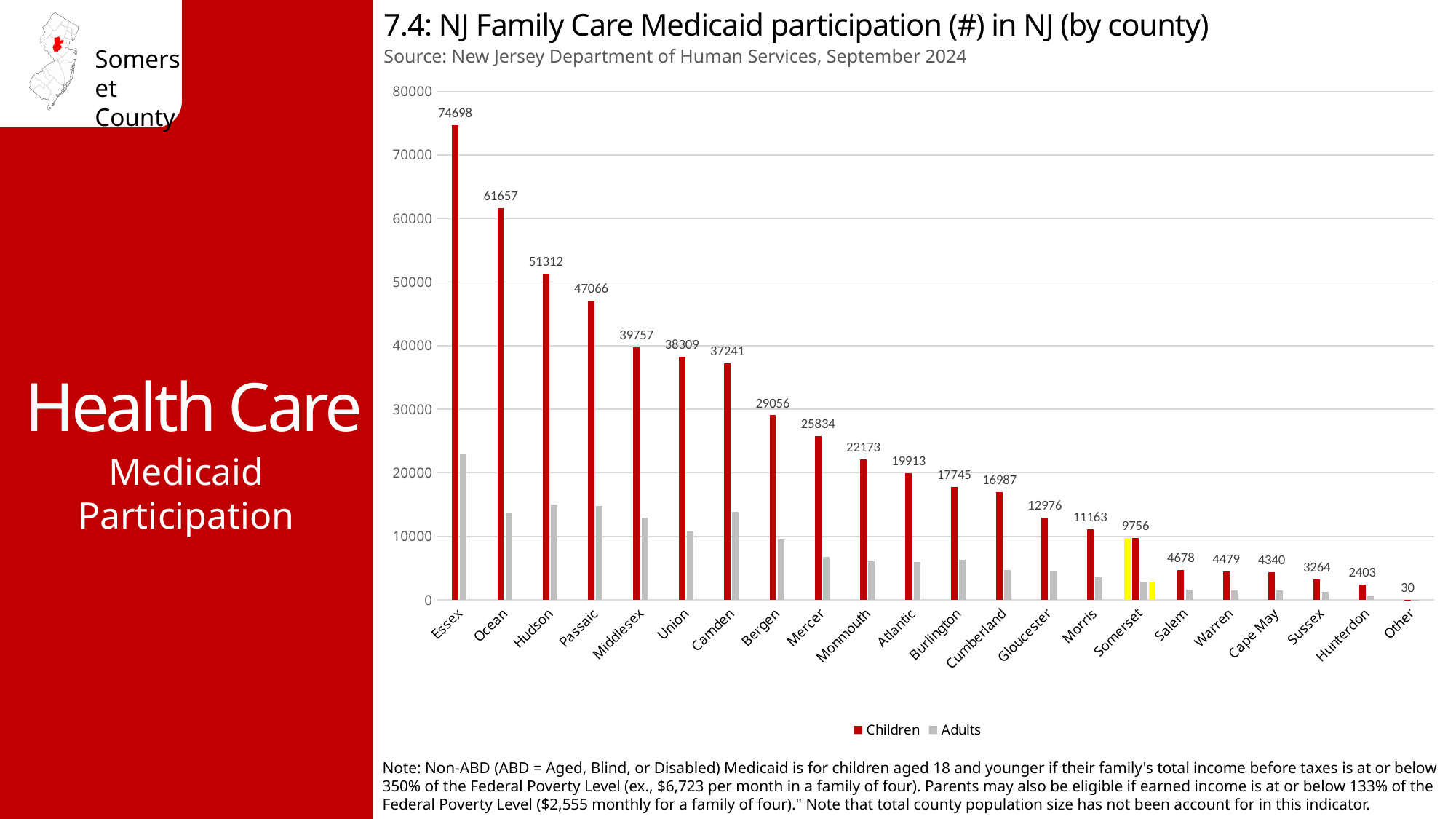
What is the Children value for Essex? 74698 Which county has the lowest Children value (excluding Other)? Hunterdon Is the Adults value for Essex greater or less than 20000? greater What is the Children value for Somerset? 9756 What is the Children value for Hunterdon? 2403 What is the difference between the Children values for Essex and Ocean? 13041 How many counties/categories are shown on the x axis? 22 What kind of chart is shown on the slide? Bar chart Which has a larger Children value, Bergen or Mercer? Bergen What is the difference between the Children values for Somerset and Salem? 5078 How many series does the legend list? 2 Which county has the highest Children value? Essex